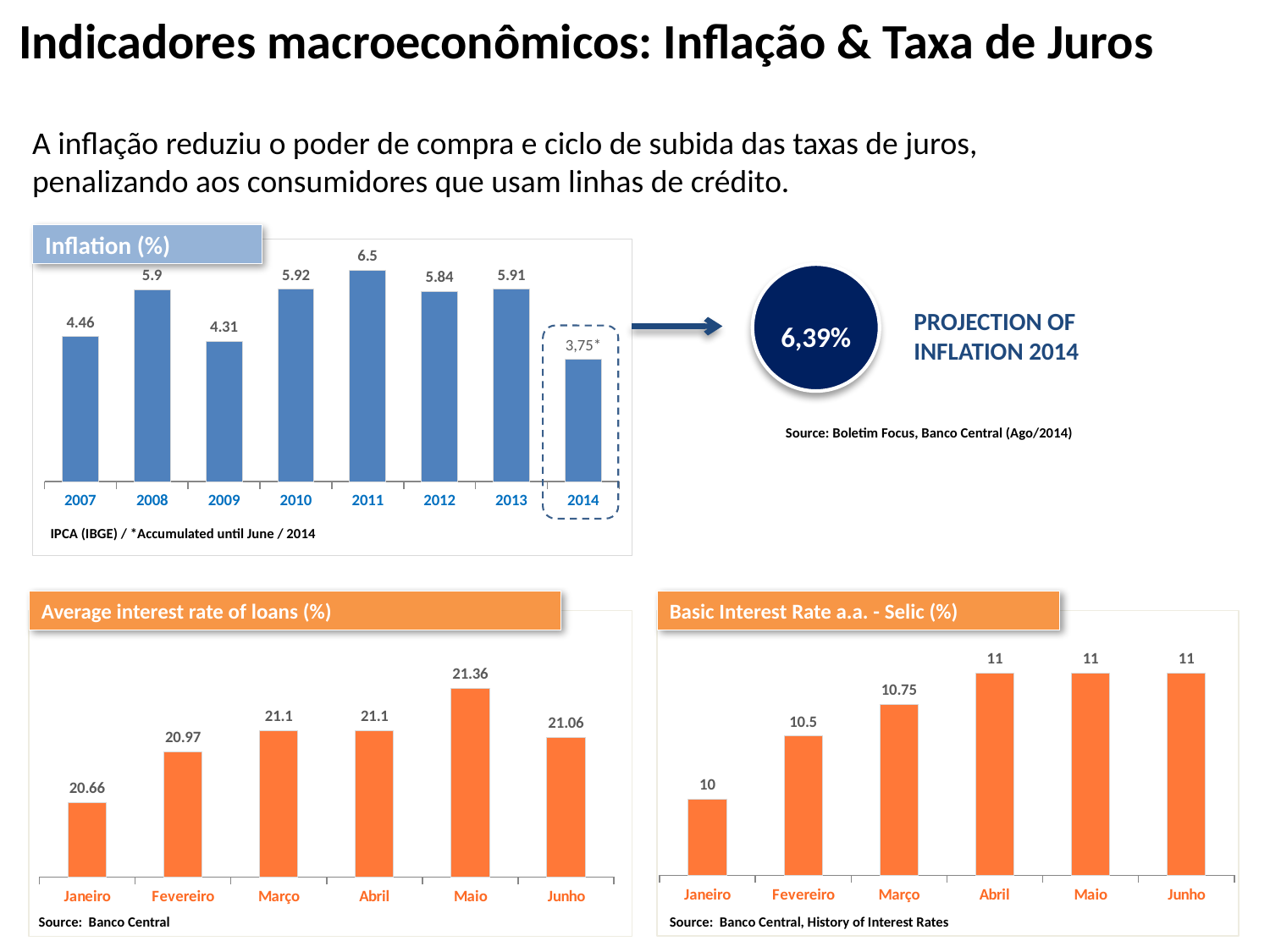
What kind of chart is the 'Basic Interest Rate a.a. - Selic (%)' chart? bar chart In the 'Basic Interest Rate a.a. - Selic (%)' chart, what is the value for Março? 10.75 In the 'Basic Interest Rate a.a. - Selic (%)' chart, what is the difference between the values for Junho and Janeiro? 1 In the 'Inflation (%)' chart, what is the difference between the values for 2008 and 2009? 1.59 In the 'Inflation (%)' chart, which year has the lowest inflation value? 2014 In the 'Average interest rate of loans (%)' chart, which month has the lowest value? Janeiro In the 'Inflation (%)' chart, what is the value shown for 2014? 3,75* In the 'Basic Interest Rate a.a. - Selic (%)' chart, do the values rise or fall from Janeiro to Abril? rise In the 'Average interest rate of loans (%)' chart, which is larger, the value for Fevereiro or the value for Junho? Junho In the 'Inflation (%)' chart, what is the value for 2011? 6.5 In the 'Average interest rate of loans (%)' chart, what is the value for Maio? 21.36 In the 'Inflation (%)' chart, how many years are plotted? 8